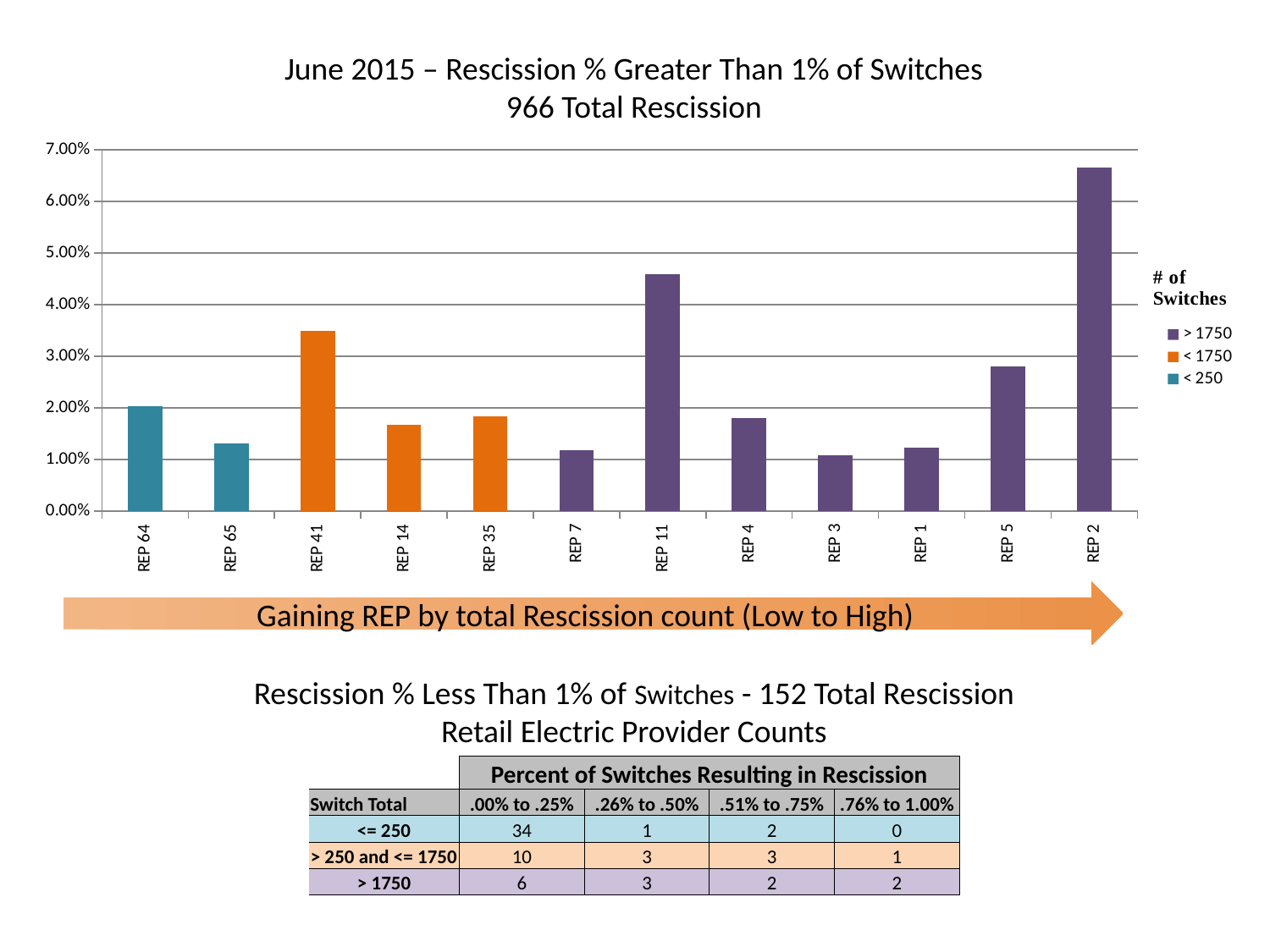
Is the value for REP 5 greater or less than 3.00%? less Is the value for REP 41 greater or less than 3.00%? greater Is the value for REP 14 greater or less than 2.00%? less Which legend series (by number of switches) does the bar for REP 2 belong to? > 1750 Which REP has the highest rescission percentage in the chart? REP 2 Which has the larger rescission percentage, REP 11 or REP 41? REP 11 How many REP categories are plotted on the x axis of the chart? 12 Which has the larger rescission percentage, REP 41 or REP 5? REP 41 What kind of chart is shown on the slide? bar chart How many series does the chart's legend list? 3